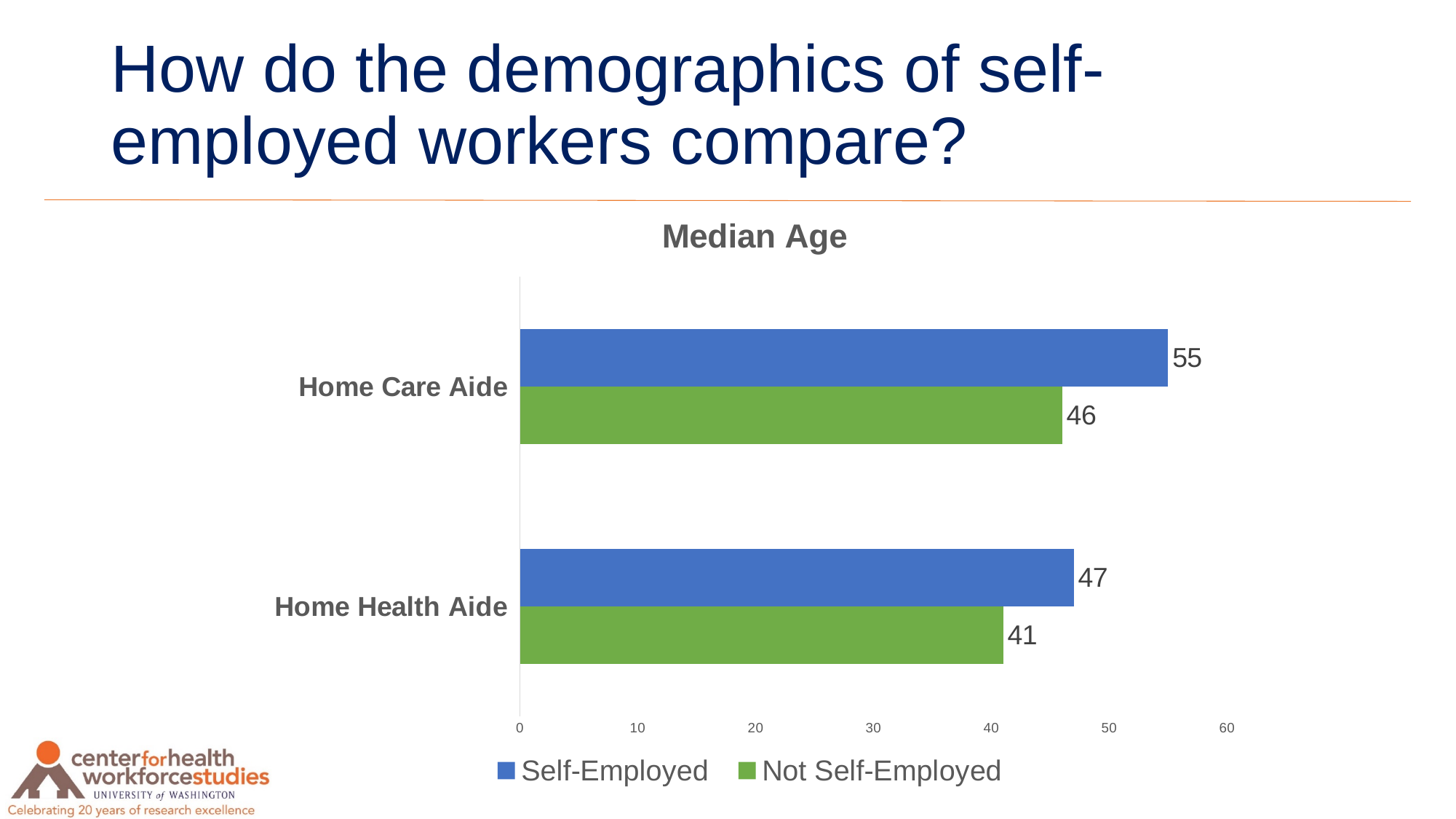
What is the median age of Home Care Aides who are not self-employed? 46 What is the difference in median age between self-employed and not self-employed Home Health Aides? 6 What is the difference in median age between self-employed and not self-employed Home Care Aides? 9 What type of chart is shown on the slide? Bar chart What is the median age of Home Health Aides who are not self-employed? 41 What is the median age of self-employed Home Care Aides? 55 Which is larger: the median age of self-employed Home Health Aides or not self-employed Home Care Aides? Self-employed Home Health Aides How many series does the legend list? 2 What is the median age of self-employed Home Health Aides? 47 What is the title of the chart? Median Age Which category has the highest median age for self-employed workers? Home Care Aide Which category has the lowest median age for workers who are not self-employed? Home Health Aide